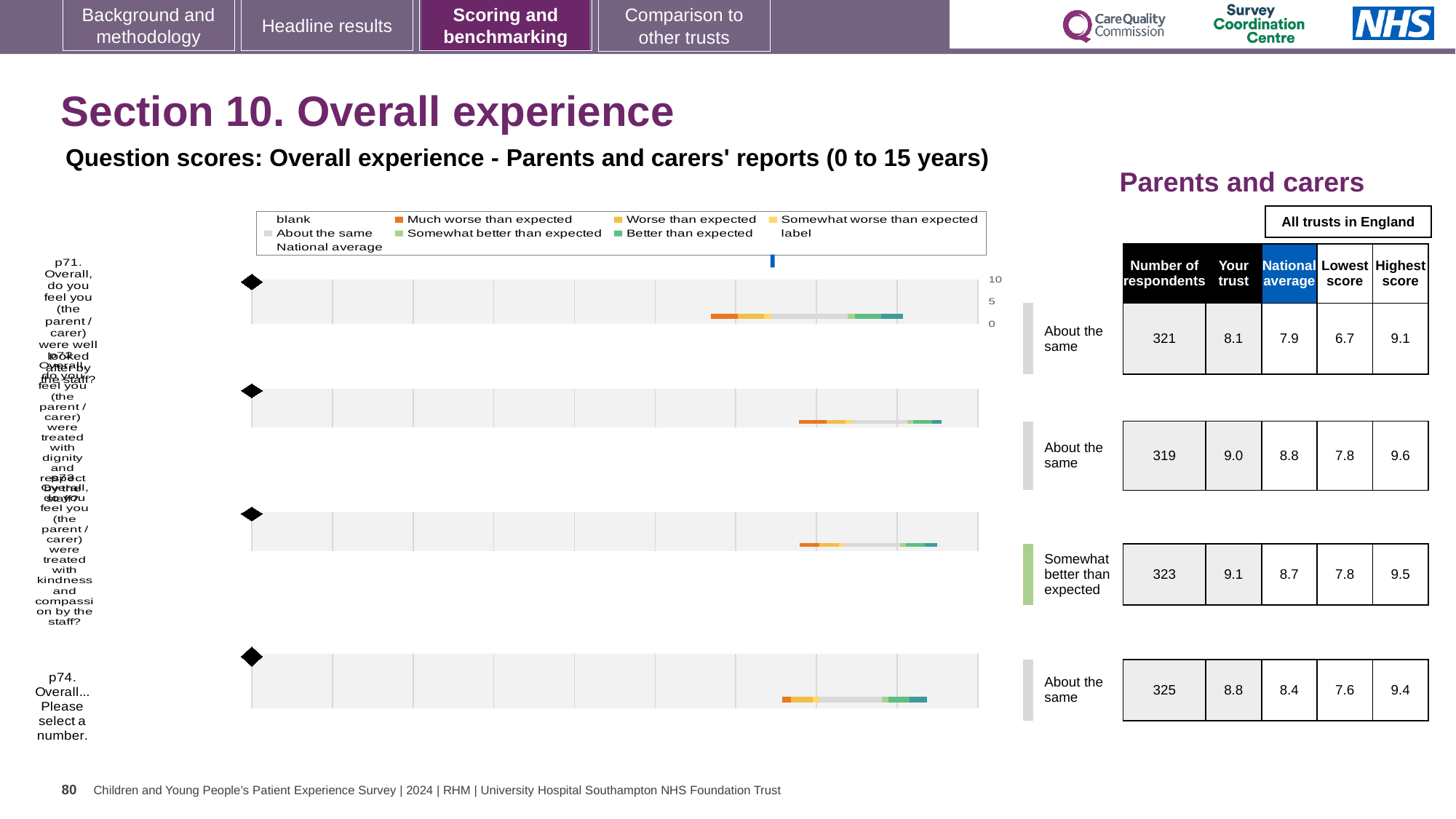
What kind of chart is shown on the slide? bar chart For the second row, which is larger: the 'Your trust' score or the 'National average'? Your trust (9.0) Which row has the highest 'Your trust' score? the third row (9.1) What benchmark category is given for the third row? Somewhat better than expected How many question rows (bars) does the chart show? 4 What is the subtitle above the chart? Question scores: Overall experience - Parents and carers' reports (0 to 15 years) How many rows are rated 'About the same'? 3 What is the 'Highest score' for the first row? 9.1 What is the 'Your trust' score for the fourth row (p74. Overall... Please select a number)? 8.8 What is the difference between 'Your trust' and 'National average' for the first row? 0.2 How many respondents are listed for the fourth row (p74)? 325 What colour does the legend use for 'Much worse than expected'? orange